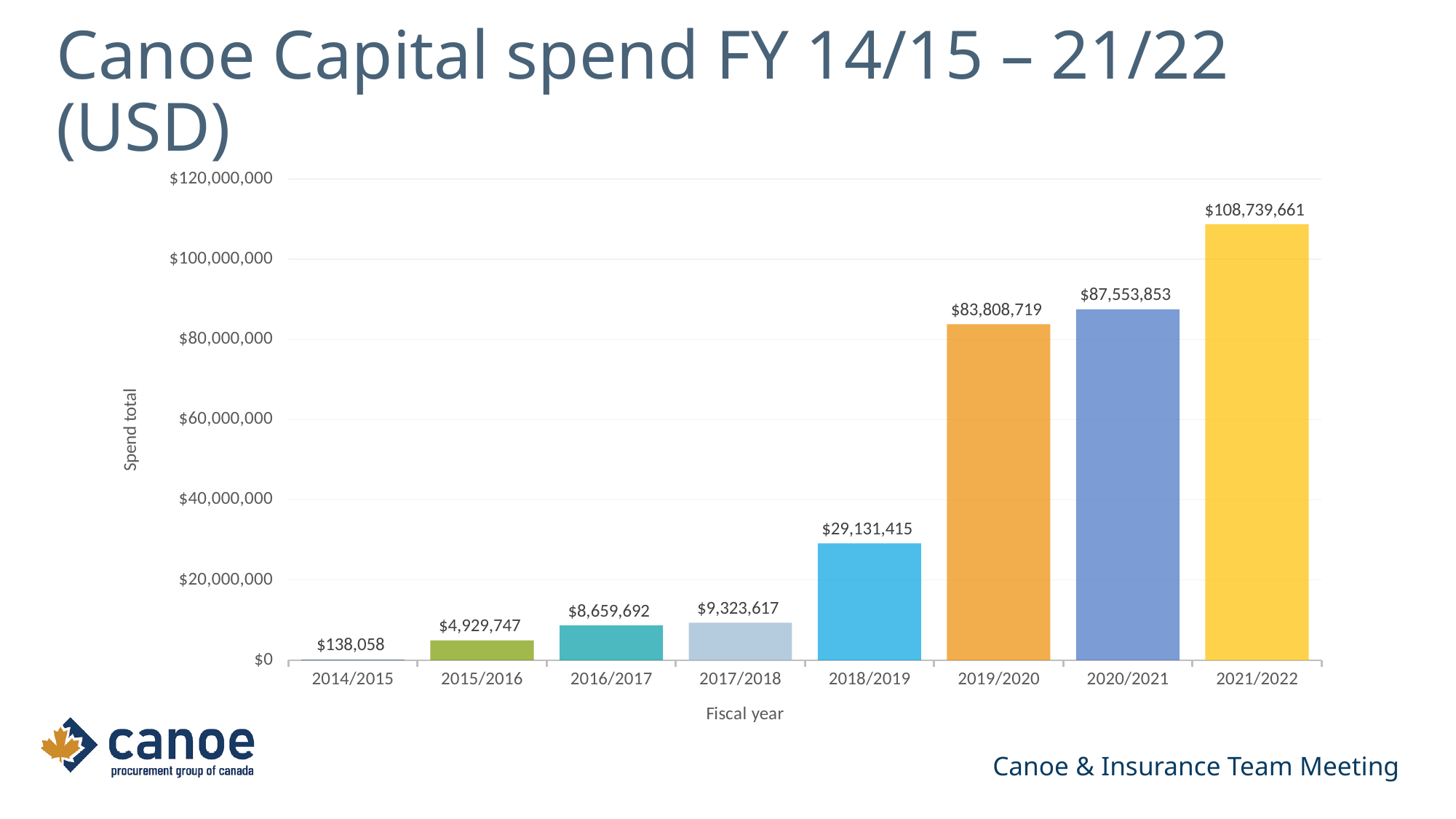
What is the spend total for fiscal year 2014/2015? $138,058 Which fiscal year has the lowest spend total? 2014/2015 Is the spend total for 2018/2019 greater or less than $20,000,000? greater Does the spend total rise or fall from 2014/2015 to 2021/2022? rise Which fiscal year has a larger spend total, 2019/2020 or 2020/2021? 2020/2021 What is the spend total for fiscal year 2018/2019? $29,131,415 How many fiscal years are shown on the chart? 8 Which fiscal year has the highest spend total? 2021/2022 What is the spend total for fiscal year 2015/2016? $4,929,747 What kind of chart is shown on the slide? bar chart What is the difference in spend total between 2021/2022 and 2020/2021? $21,185,808 What is the difference in spend total between 2020/2021 and 2019/2020? $3,745,134